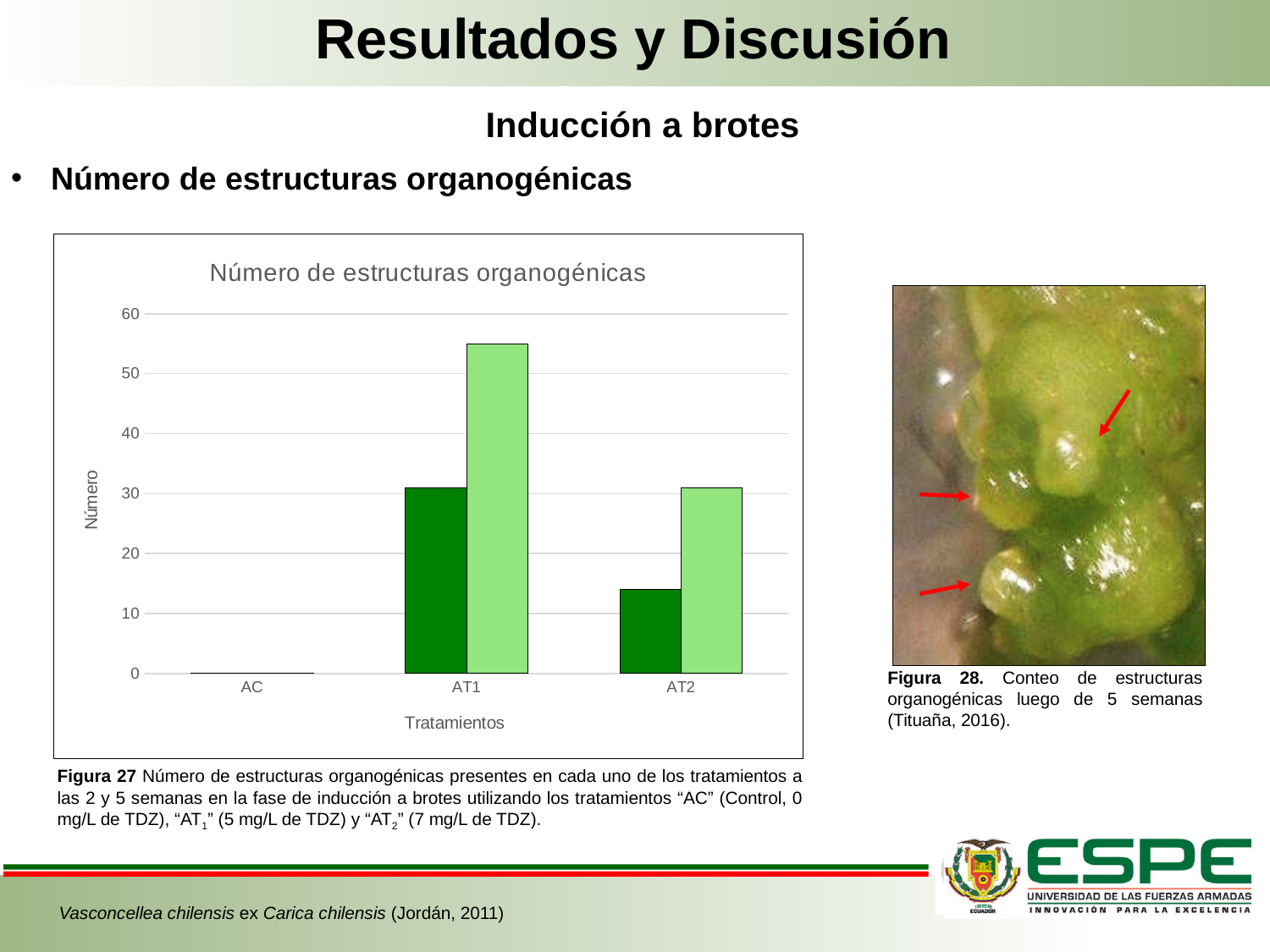
Which treatment has the lowest values in the chart? AC Is the value of the light green bar for AT2 greater or less than 40? less Which treatment has the tallest bar in the chart? AT1 What is the label of the y axis of the chart? Número Is the value of the dark green bar for AT1 greater or less than 40? less Is the value of the dark green bar for AT2 greater or less than 10? greater What is the title of the chart? Número de estructuras organogénicas How many treatment categories are shown on the x axis of the chart? 3 Which is larger: the dark green bar for AT2 or the dark green bar for AT1? AT1 What kind of chart is shown on the slide? bar chart Which is larger: the light green bar for AT1 or the light green bar for AT2? AT1